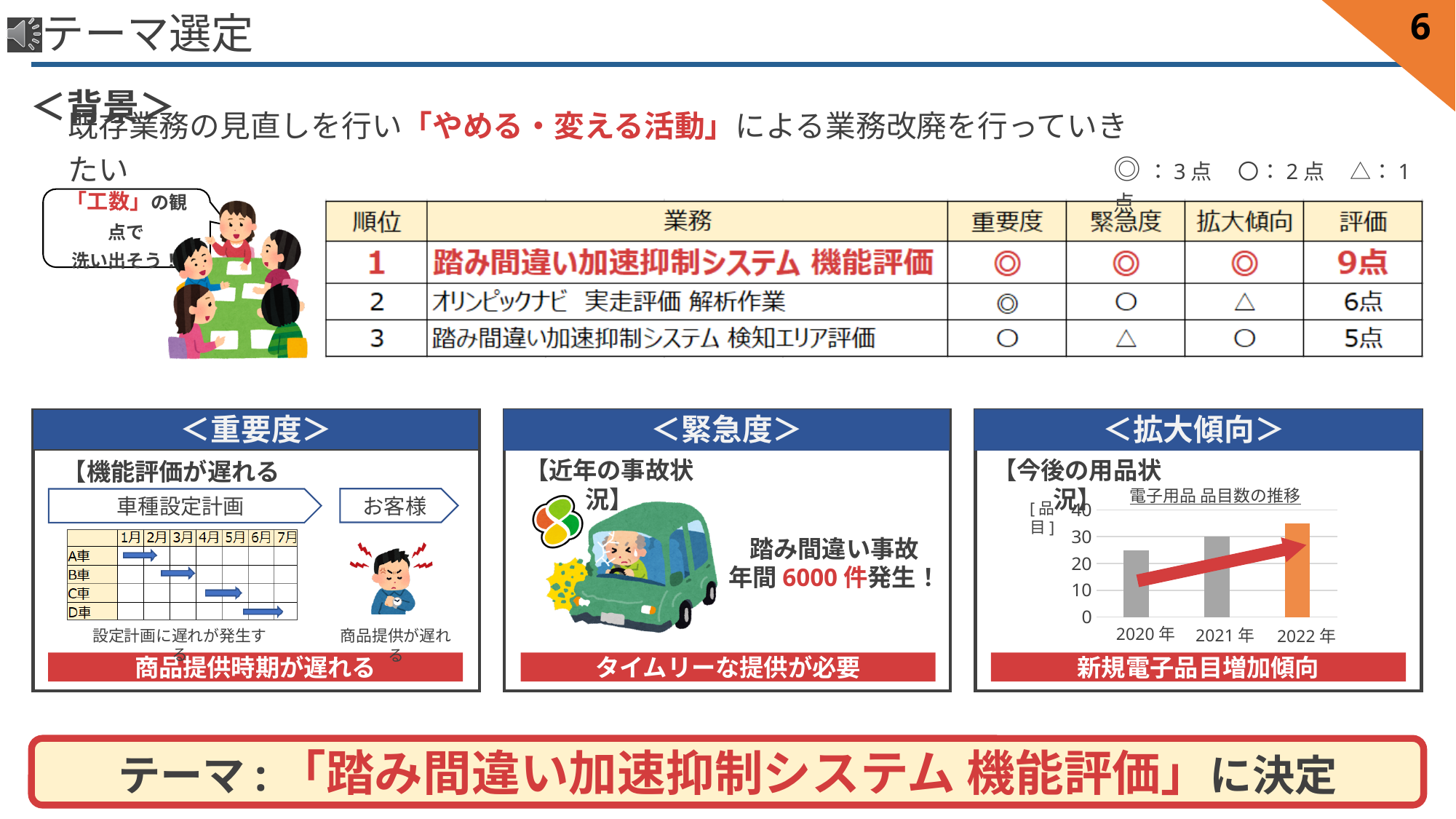
In the 電子用品 品目数の推移 chart, is the value for 2022年 greater or less than 30? greater In the 電子用品 品目数の推移 chart, what colour is the bar for 2022年? orange Which year has the lowest bar in the 電子用品 品目数の推移 chart? 2020年 What kind of chart is the 電子用品 品目数の推移 chart? bar chart In the 電子用品 品目数の推移 chart, is the value for 2020年 greater or less than 30? less How many years are shown on the x axis of the 電子用品 品目数の推移 chart? 3 In the 電子用品 品目数の推移 chart, is the value for 2022年 greater or less than 40? less Which year has the highest bar in the 電子用品 品目数の推移 chart? 2022年 In the 電子用品 品目数の推移 chart, which is larger, the value for 2021年 or the value for 2022年? 2022年 In the 電子用品 品目数の推移 chart, do the values rise or fall from 2020年 to 2022年? rise What is the title of the bar chart in the 拡大傾向 panel? 電子用品 品目数の推移